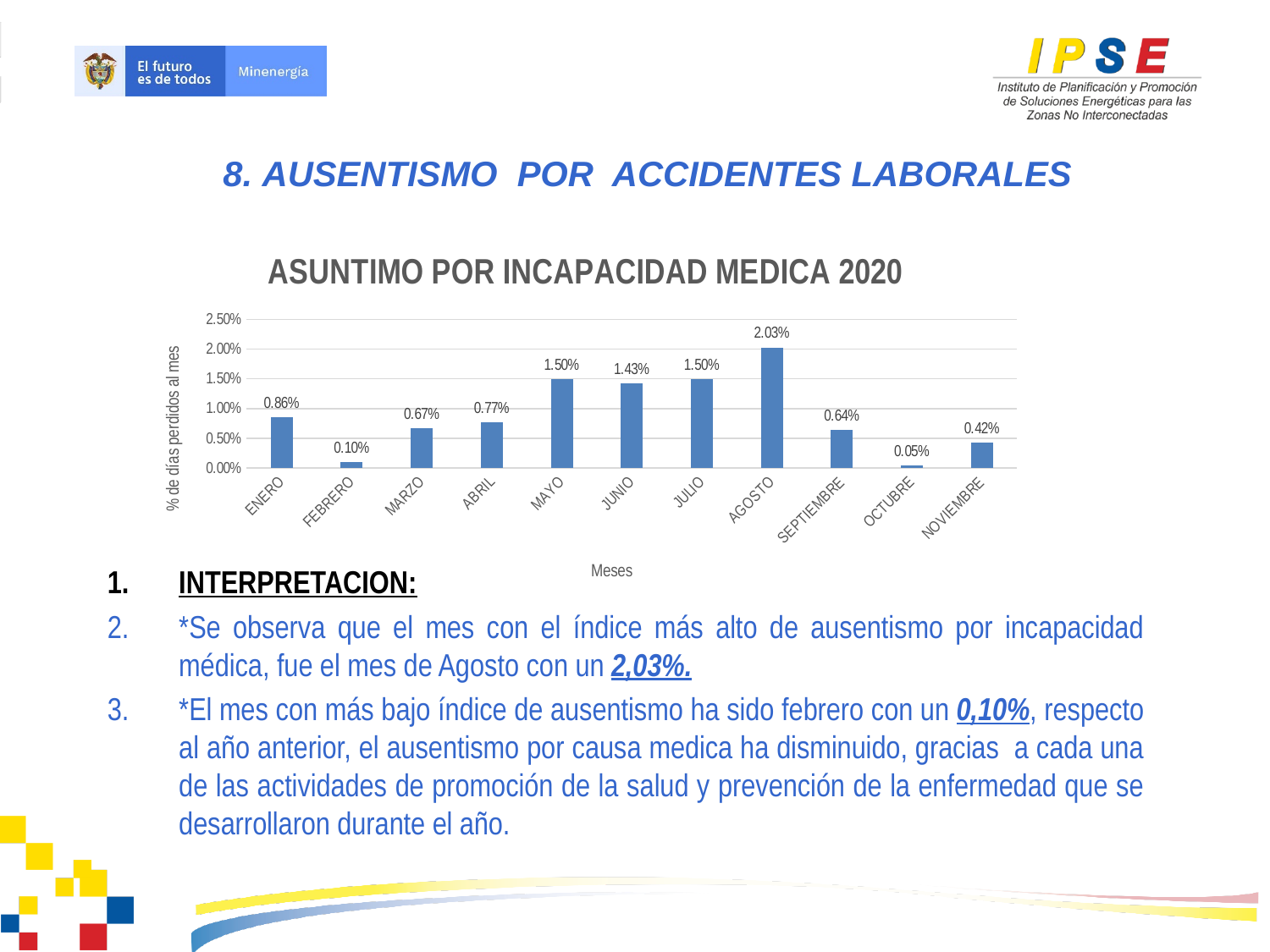
What kind of chart is shown on the slide? Bar chart What is the value for AGOSTO in the chart? 2.03% What is the label of the x axis of the chart? Meses Which is larger, the value for ENERO or the value for ABRIL? ENERO What is the value for JUNIO in the chart? 1.43% Which month has the lowest value in the chart? OCTUBRE Which month has the highest value in the chart? AGOSTO Is the value for MAYO greater or less than 1.00%? greater What is the title of the chart? ASUNTIMO POR INCAPACIDAD MEDICA 2020 What is the value for FEBRERO in the chart? 0.10% What is the difference between the values for AGOSTO and SEPTIEMBRE? 1.39% How many months are shown on the x axis of the chart? 11